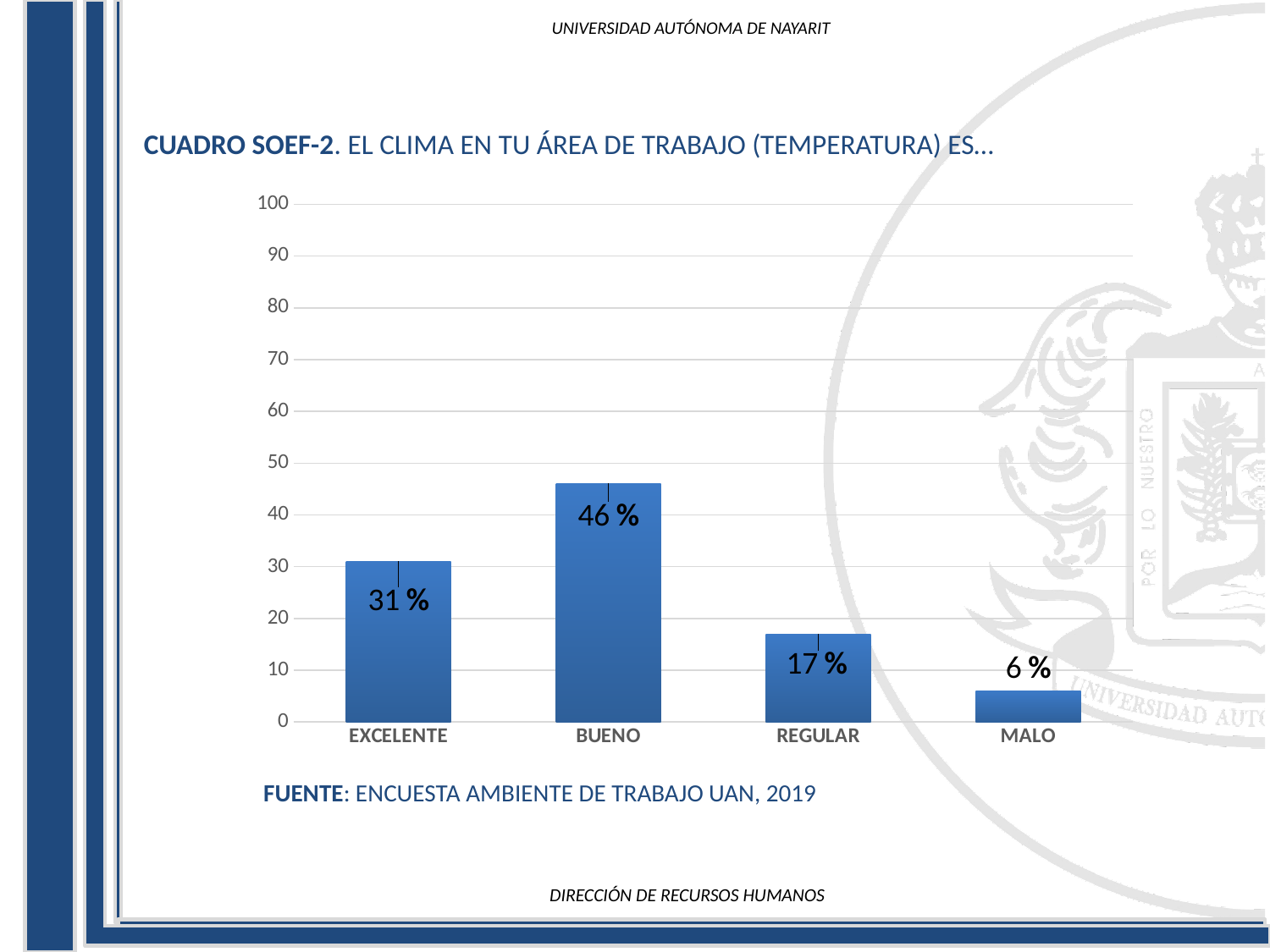
Which is larger, the value for EXCELENTE or the value for REGULAR? EXCELENTE What is the difference between the values for BUENO and EXCELENTE? 15 % What kind of chart is shown on the slide? bar chart What is the difference between the values for REGULAR and MALO? 11 % Is the value for BUENO greater or less than 50? less What is the value for EXCELENTE? 31 % What is the value for REGULAR? 17 % Which category has the highest value? BUENO How many categories are shown on the x axis? 4 What is the value for MALO? 6 % Which category has the lowest value? MALO What is the value for BUENO? 46 %